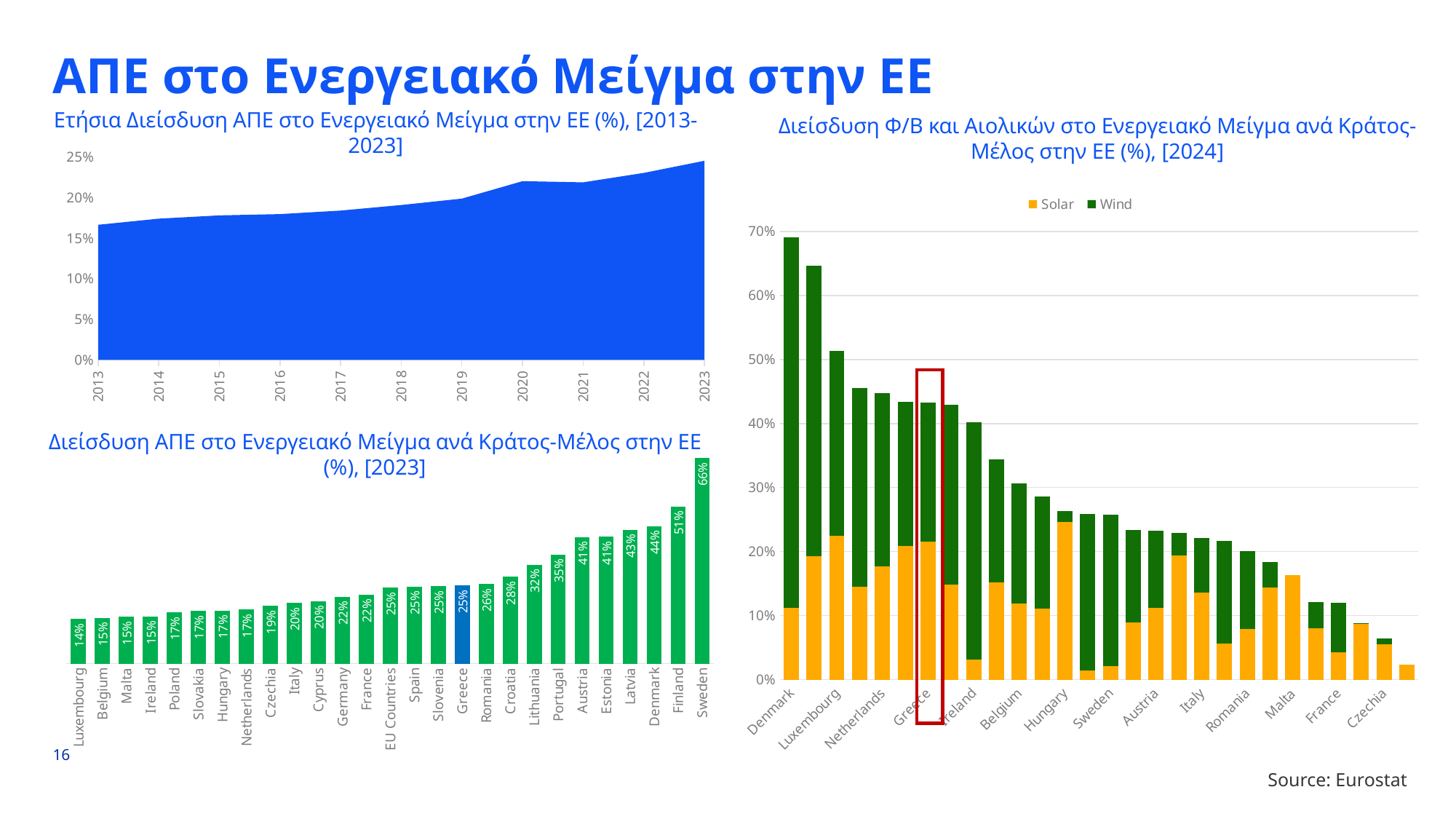
In the right-hand chart (Διείσδυση Φ/Β και Αιολικών, 2024), is the total value for Greece greater or less than 40%? greater In the top-left chart (Ετήσια Διείσδυση ΑΠΕ στην ΕΕ, 2013-2023), do the values rise or fall from 2013 to 2023? rise How many bars are plotted in the bottom-left chart (Διείσδυση ΑΠΕ ανά Κράτος-Μέλος, 2023)? 27 In the bottom-left chart (Διείσδυση ΑΠΕ ανά Κράτος-Μέλος, 2023), what is the difference between Sweden and Finland? 15 percentage points How many series does the legend of the right-hand chart (Διείσδυση Φ/Β και Αιολικών, 2024) list? 2 In the bottom-left chart (Διείσδυση ΑΠΕ ανά Κράτος-Μέλος, 2023), which is larger, Portugal or Lithuania? Portugal In the bottom-left chart (Διείσδυση ΑΠΕ ανά Κράτος-Μέλος, 2023), what is the value for Sweden? 66% In the right-hand chart (Διείσδυση Φ/Β και Αιολικών, 2024), which country is highlighted with a red box? Greece In the right-hand chart (Διείσδυση Φ/Β και Αιολικών, 2024), which country has the highest total bar? Denmark In the right-hand chart (Διείσδυση Φ/Β και Αιολικών, 2024), is the total value for Czechia greater or less than 10%? less In the bottom-left chart (Διείσδυση ΑΠΕ ανά Κράτος-Μέλος, 2023), which country has the lowest value? Luxembourg In the bottom-left chart (Διείσδυση ΑΠΕ ανά Κράτος-Μέλος, 2023), what is the value for Greece? 25%